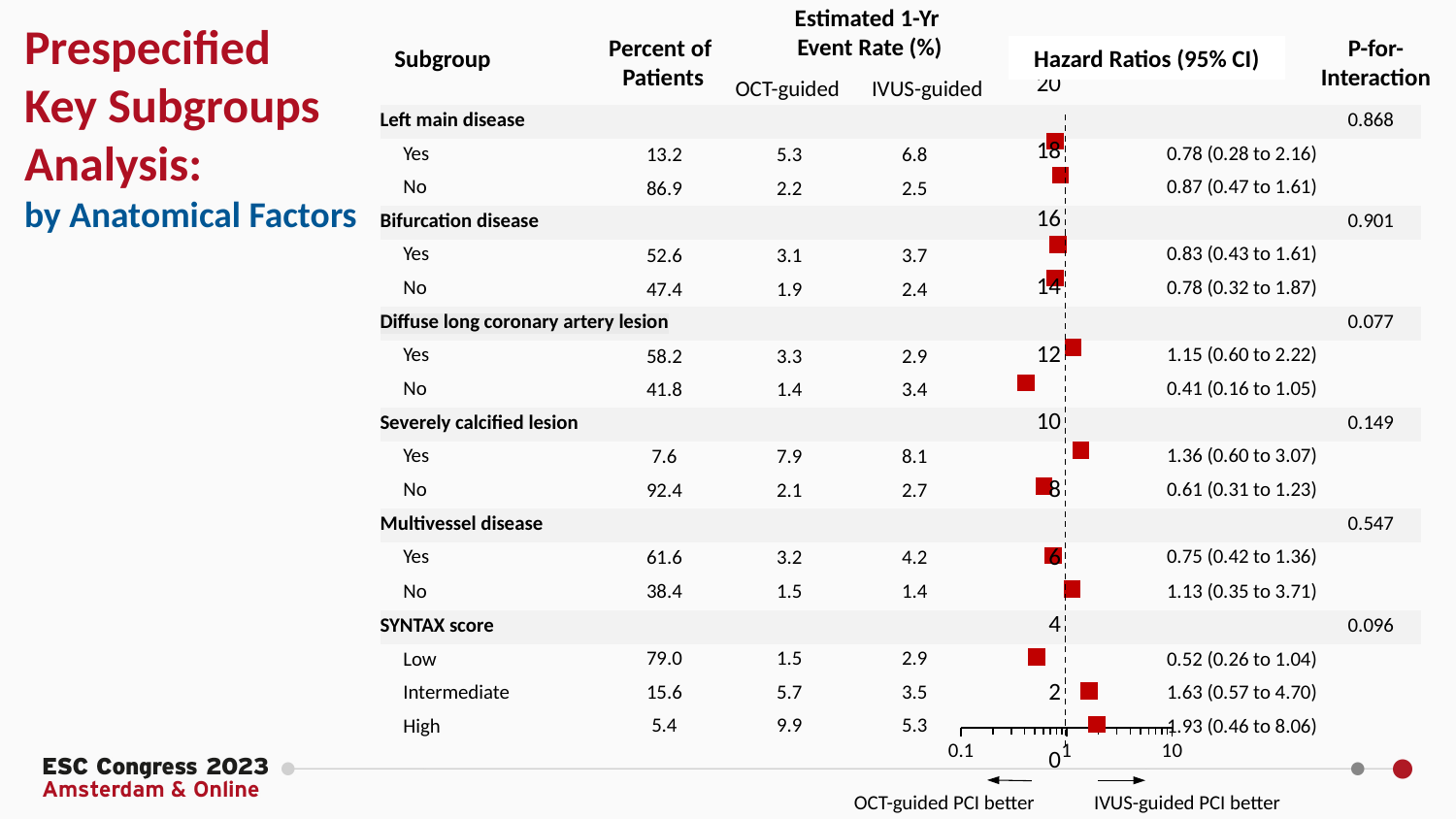
How many subgroup hazard ratio points are plotted in the forest plot? 13 What kind of chart is shown on the slide? Forest plot Is the hazard ratio point estimate for the SYNTAX score 'Low' subgroup greater or less than 1? less Which subgroup has the highest hazard ratio point estimate in the forest plot? SYNTAX score High (1.93) What is the hazard ratio (95% CI) for the Diffuse long coronary artery lesion 'No' subgroup? 0.41 (0.16 to 1.05) Which subgroup has the lowest hazard ratio point estimate in the forest plot? Diffuse long coronary artery lesion No (0.41) Which subgroup category has the lowest P-for-interaction value? Diffuse long coronary artery lesion (0.077) What is the difference between the hazard ratio point estimates for Multivessel disease 'No' and 'Yes'? 0.38 What is the hazard ratio (95% CI) for the Left main disease 'Yes' subgroup? 0.78 (0.28 to 2.16) According to the label below the x axis, which treatment is favoured by hazard ratios to the left of 1? OCT-guided PCI better What is the hazard ratio (95% CI) for the SYNTAX score 'Intermediate' subgroup? 1.63 (0.57 to 4.70) Which has the larger hazard ratio point estimate: Severely calcified lesion 'Yes' or 'No'? Yes (1.36)